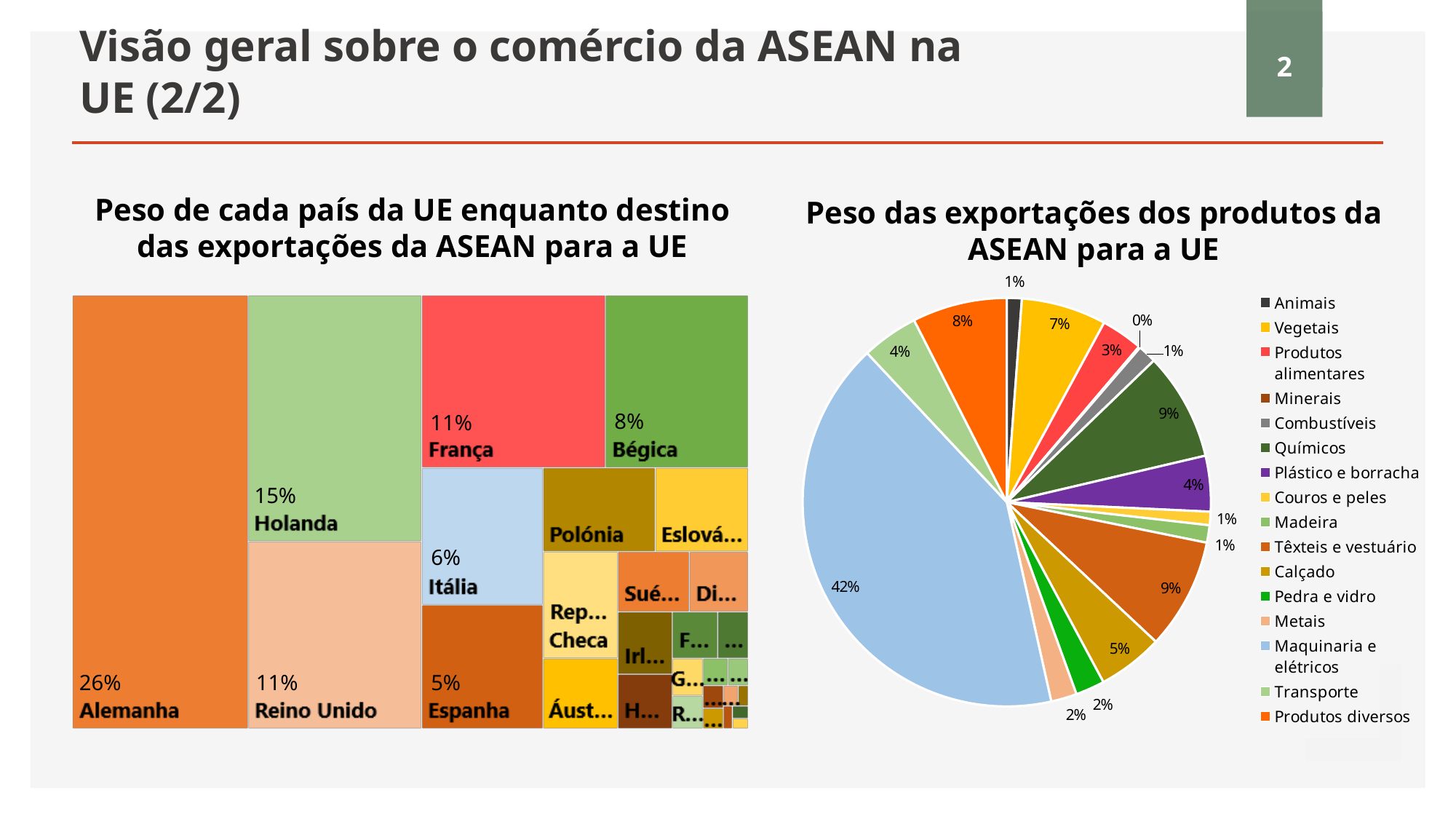
What kind of chart is 'Peso de cada país da UE enquanto destino das exportações da ASEAN para a UE'? Treemap In the chart 'Peso das exportações dos produtos da ASEAN para a UE', what is the share of Químicos? 9% In the chart 'Peso de cada país da UE enquanto destino das exportações da ASEAN para a UE', what is the difference between the shares of Alemanha and Holanda? 11 percentage points In the chart 'Peso de cada país da UE enquanto destino das exportações da ASEAN para a UE', which country has the highest share? Alemanha How many categories does the legend of the chart 'Peso das exportações dos produtos da ASEAN para a UE' list? 16 What kind of chart is 'Peso das exportações dos produtos da ASEAN para a UE'? Pie chart In the chart 'Peso de cada país da UE enquanto destino das exportações da ASEAN para a UE', which is larger, the share of Itália or the share of Espanha? Itália In the chart 'Peso de cada país da UE enquanto destino das exportações da ASEAN para a UE', what is the value for Alemanha? 26% In the chart 'Peso das exportações dos produtos da ASEAN para a UE', what is the share of Maquinaria e elétricos? 42% In the chart 'Peso de cada país da UE enquanto destino das exportações da ASEAN para a UE', what is the value for Holanda? 15% In the chart 'Peso das exportações dos produtos da ASEAN para a UE', which product category has the largest slice? Maquinaria e elétricos In the chart 'Peso das exportações dos produtos da ASEAN para a UE', what is the difference between the shares of Produtos diversos and Vegetais? 1 percentage point